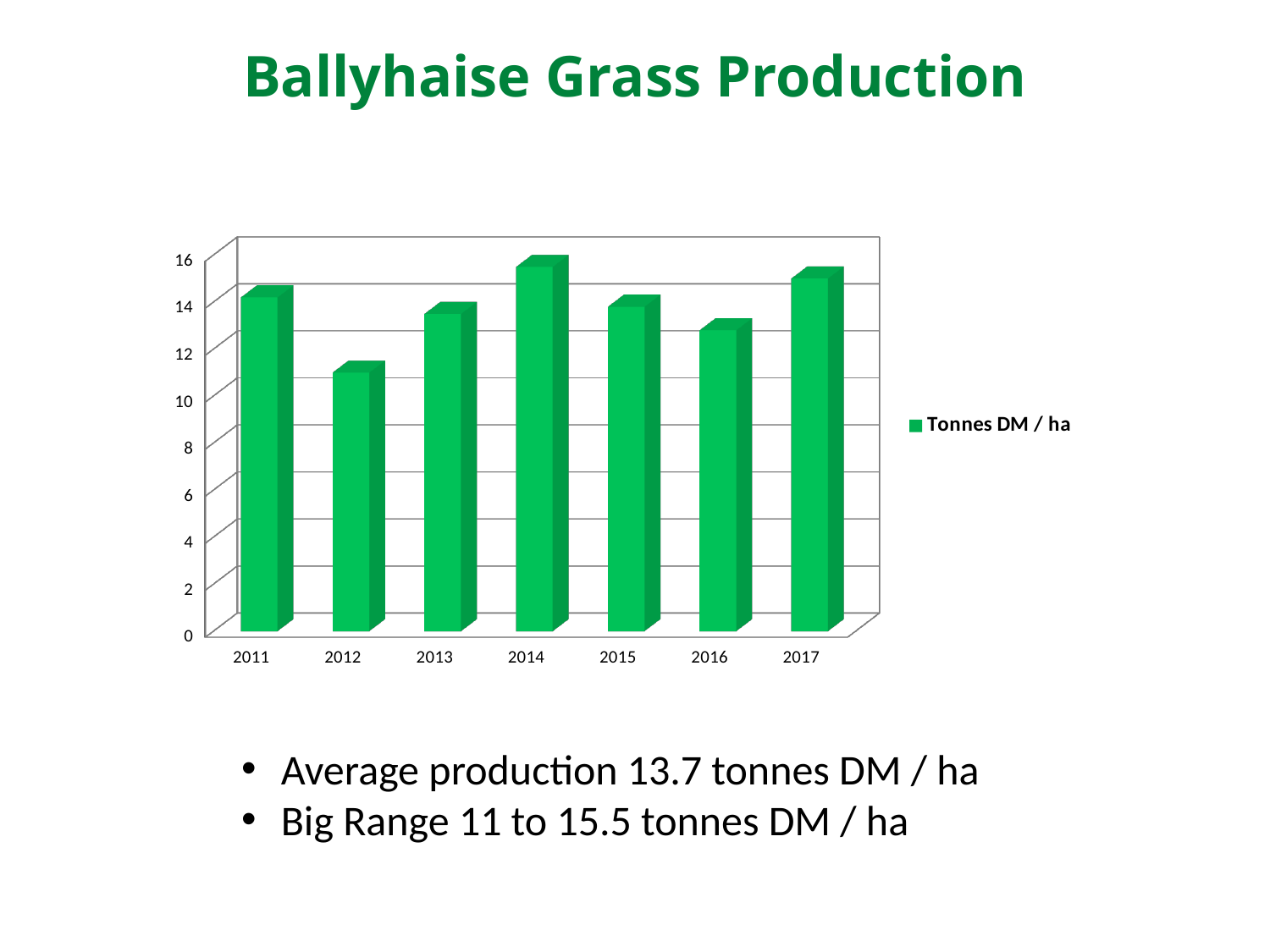
Is the value for 2016 greater or less than 14? less Which year has the highest grass production? 2014 Does the value rise or fall from 2011 to 2012? fall How many years are plotted on the chart? 7 Is the value for 2014 greater or less than 14? greater What kind of chart is shown on the slide? bar chart What series name is shown in the legend? Tonnes DM / ha Which is larger, the value for 2011 or the value for 2016? 2011 How many series does the legend list? 1 Is the value for 2017 greater or less than 14? greater Which year has the lowest grass production? 2012